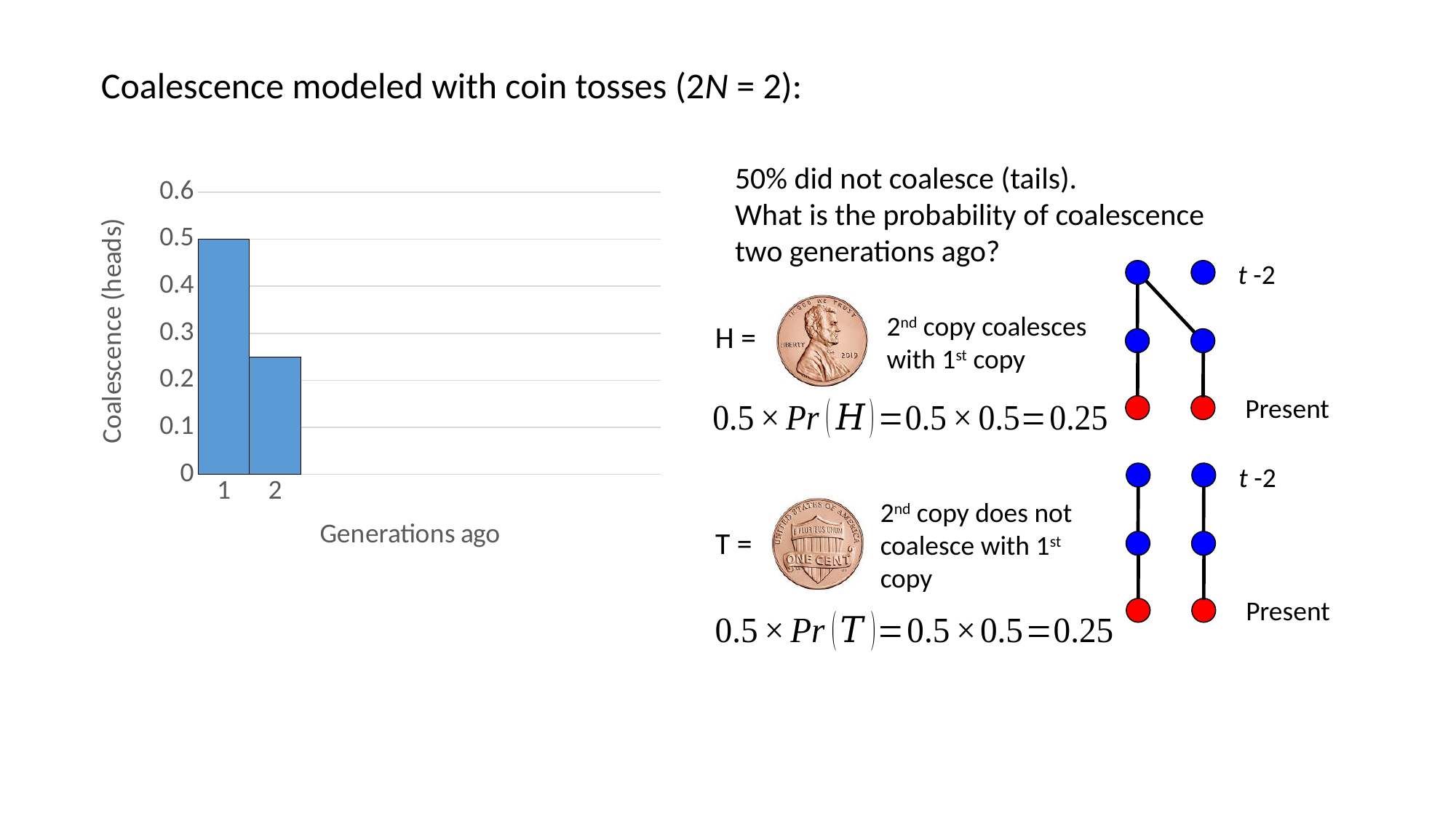
Which generation has the highest coalescence value in the chart? 1 How many categories (generations) are plotted on the x axis of the chart? 2 Is the coalescence value for generation 2 greater or less than 0.2? greater What is the title of the vertical axis of the chart? Coalescence (heads) What is the coalescence value for generation 1 in the chart? 0.5 What is the title of the horizontal axis of the chart? Generations ago What kind of chart is shown on the slide? bar chart Do the bar values rise or fall from generation 1 to generation 2? fall Is the coalescence value for generation 1 greater or less than 0.4? greater Which bar is taller in the chart, generation 1 or generation 2? 1 Which generation has the lowest coalescence value in the chart? 2 Is the coalescence value for generation 2 greater or less than 0.3? less